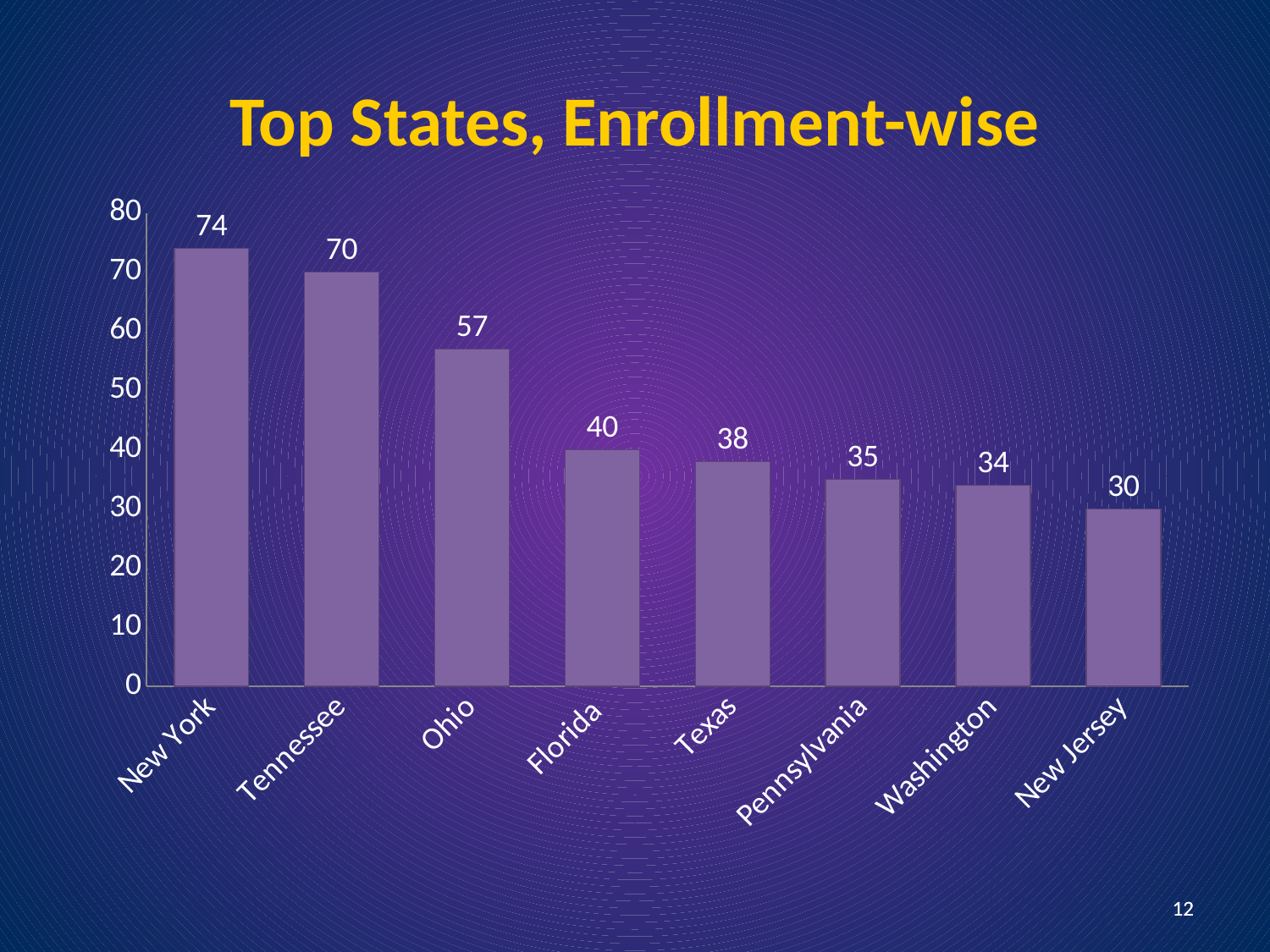
Which has a higher enrollment value, Texas or Washington? Texas What is the difference between the enrollment values for New York and Tennessee? 4 Which state has the highest enrollment? New York Is the value for Florida greater or less than 50? less How many states are shown in the chart? 8 What is the enrollment value for Pennsylvania? 35 What is the enrollment value for Ohio? 57 What is the difference between the enrollment values for Ohio and Florida? 17 What is the title of the chart? Top States, Enrollment-wise Which state has the lowest enrollment? New Jersey What kind of chart is shown on the slide? Bar chart Do the values rise or fall from left to right across the states? Fall